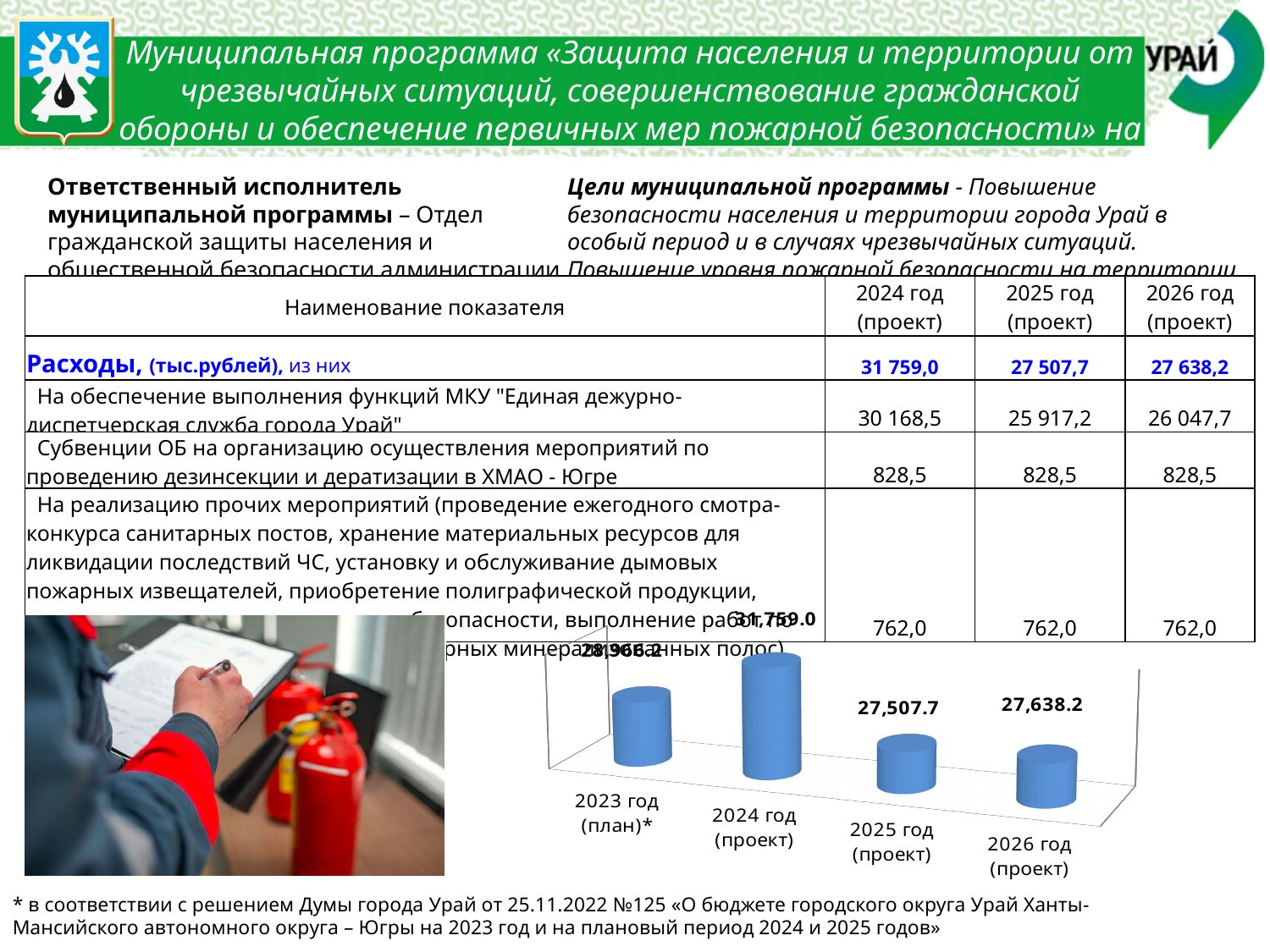
What is the value shown for 2025 год (проект) in the chart? 27,507.7 What is the value shown for 2024 год (проект) in the chart? 31,759.0 Which year has the highest value in the chart? 2024 год (проект) What is the difference between the values for 2024 год (проект) and 2025 год (проект) in the chart? 4,251.3 What is the difference between the values for 2024 год (проект) and 2026 год (проект) in the chart? 4,120.8 What is the value shown for 2026 год (проект) in the chart? 27,638.2 What kind of chart is shown at the bottom of the slide? bar chart Which is larger in the chart: the value for 2025 год (проект) or for 2026 год (проект)? 2026 год (проект) What colour are the bars in the chart? blue What is the difference between the values for 2026 год (проект) and 2025 год (проект) in the chart? 130.5 Which year has the lowest value in the chart? 2025 год (проект) How many categories (years) are plotted in the chart? 4